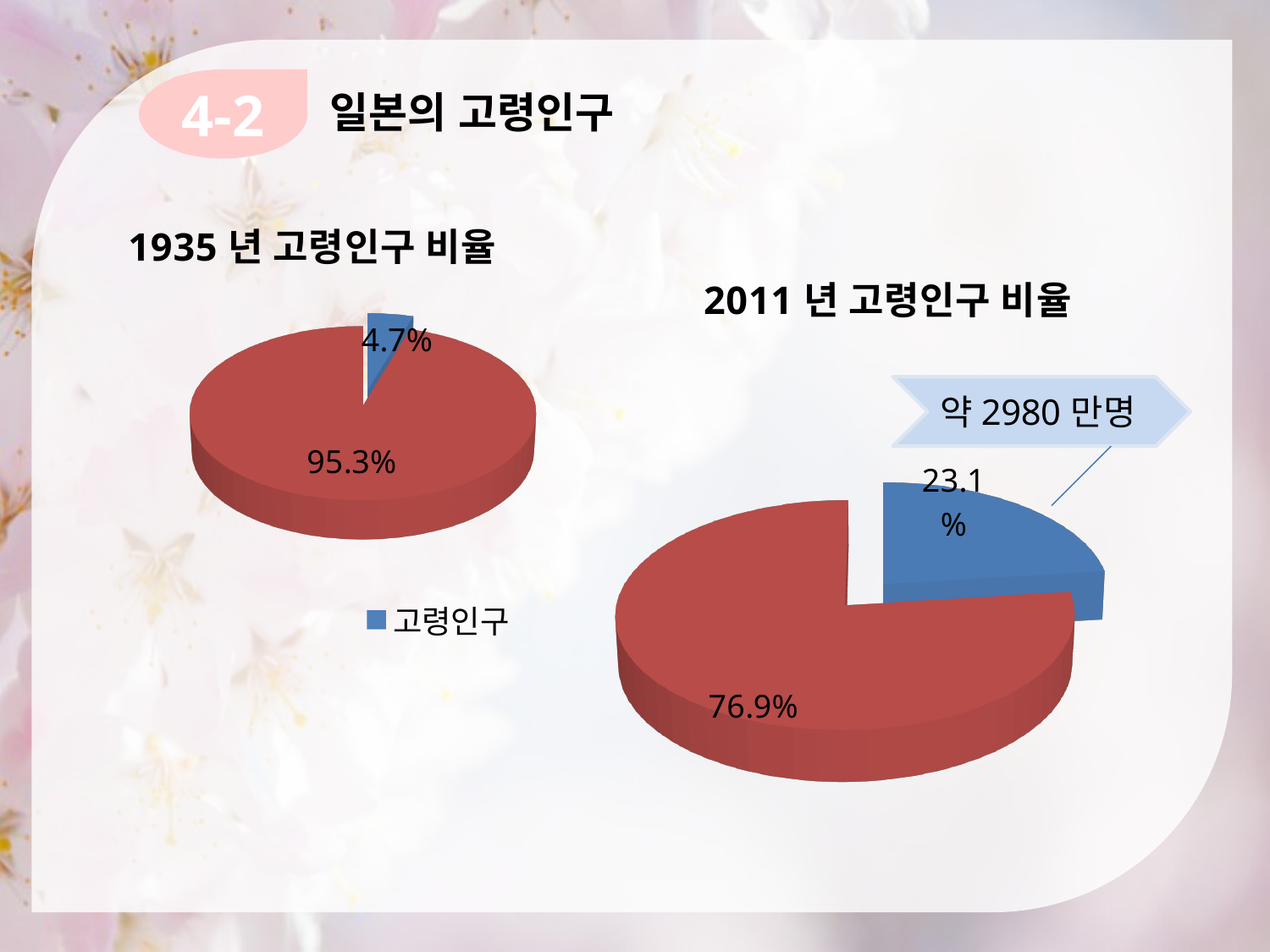
What kind of chart is the chart titled "1935 년 고령인구 비율"? Pie chart What kind of chart is the chart titled "2011 년 고령인구 비율"? Pie chart In the chart titled "2011 년 고령인구 비율", what percentage is shown for the 고령인구 (blue) slice? 23.1% What is the difference between the 고령인구 share in the chart titled "2011 년 고령인구 비율" and the 고령인구 share in the chart titled "1935 년 고령인구 비율"? 18.4% How many slices does the chart titled "1935 년 고령인구 비율" have? 2 How many slices does the chart titled "2011 년 고령인구 비율" have? 2 In the chart titled "1935 년 고령인구 비율", what percentage is shown for the 고령인구 (blue) slice? 4.7% In the chart titled "2011 년 고령인구 비율", what percentage is shown on the large red slice? 76.9% Which slice is larger in the chart titled "2011 년 고령인구 비율", the blue 고령인구 slice or the red slice? The red slice What label does the legend below the chart titled "1935 년 고령인구 비율" show for the blue slice? 고령인구 In the chart titled "1935 년 고령인구 비율", what percentage is shown on the large red slice? 95.3% Which is larger, the 고령인구 share in the chart titled "1935 년 고령인구 비율" or the 고령인구 share in the chart titled "2011 년 고령인구 비율"? 2011 년 고령인구 비율